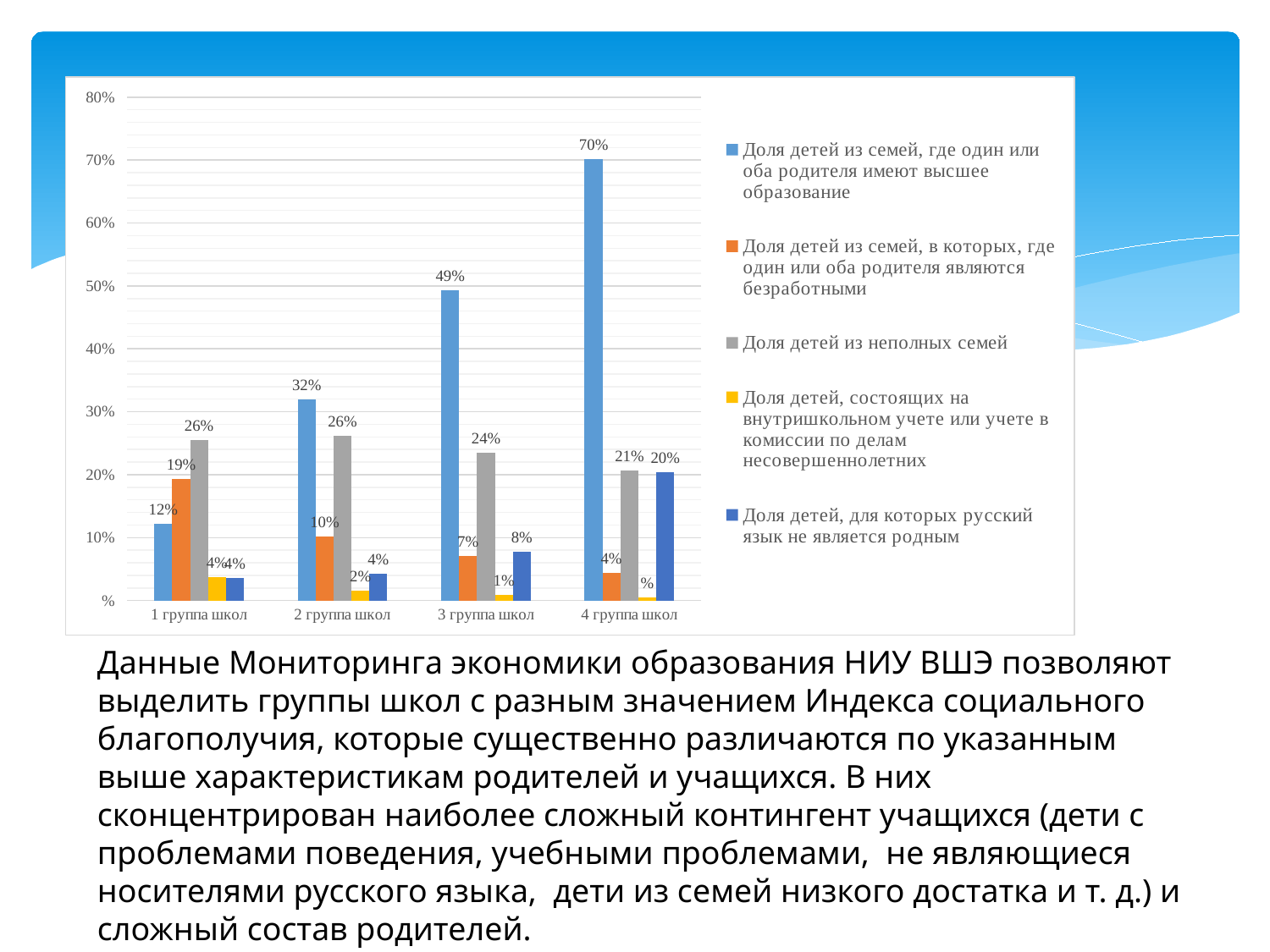
Which school group has the lowest value for 'Доля детей из семей, в которых, где один или оба родителя являются безработными'? 4 группа школ Does the value for 'Доля детей из семей, где один или оба родителя имеют высшее образование' rise or fall from 1 группа школ to 4 группа школ? rise How many series does the legend list? 5 What is the value for 'Доля детей из семей, в которых, где один или оба родителя являются безработными' in 1 группа школ? 19% What is the difference between the values for 'Доля детей из семей, где один или оба родителя имеют высшее образование' in 4 группа школ and 1 группа школ? 58% What kind of chart is shown on the slide? bar chart Which school group has the highest value for 'Доля детей из семей, где один или оба родителя имеют высшее образование'? 4 группа школ What is the value for 'Доля детей, для которых русский язык не является родным' in 4 группа школ? 20% Which is larger in 2 группа школ: 'Доля детей из семей, где один или оба родителя имеют высшее образование' or 'Доля детей из неполных семей'? Доля детей из семей, где один или оба родителя имеют высшее образование How many school groups (categories) are shown on the x axis? 4 What is the value for 'Доля детей из семей, где один или оба родителя имеют высшее образование' in 4 группа школ? 70% What is the value for 'Доля детей из неполных семей' in 3 группа школ? 24%